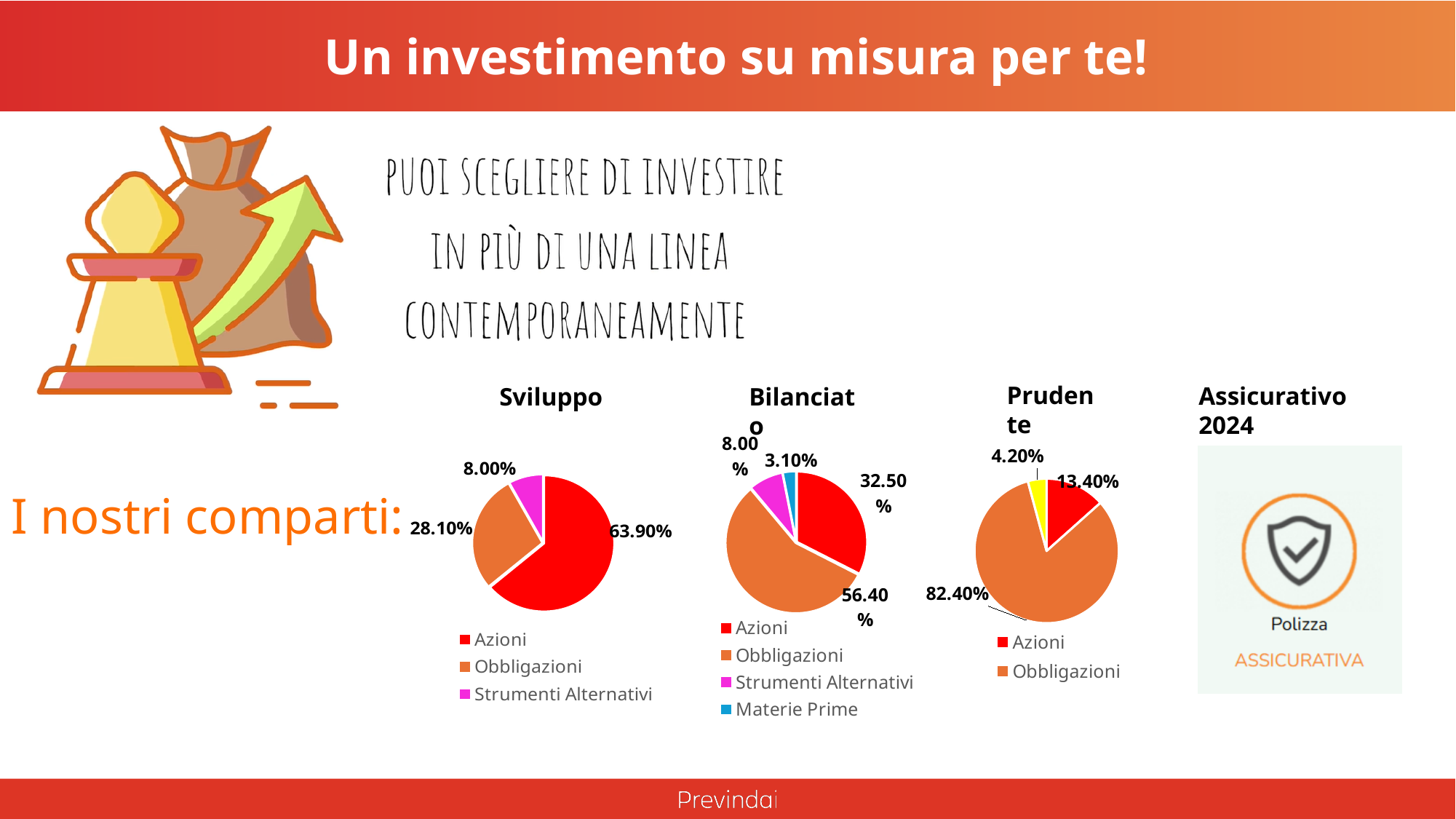
What kind of chart is the Sviluppo chart? pie chart In the Sviluppo chart, which category has the largest slice? Azioni In the Bilanciato chart, what is the difference between the Obbligazioni and Azioni shares? 23.90% How many categories does the legend of the Bilanciato chart list? 4 In the Sviluppo chart, what share is Azioni? 63.90% In the Sviluppo chart, what share is Obbligazioni? 28.10% In the Bilanciato chart, what share is Materie Prime? 3.10% In the Sviluppo chart, which category has the smallest slice? Strumenti Alternativi In the Prudente chart, which is larger, Azioni or Obbligazioni? Obbligazioni In the Prudente chart, what share is Obbligazioni? 82.40% In the Sviluppo chart, what colour is the Strumenti Alternativi slice? magenta In the Bilanciato chart, what share is Obbligazioni? 56.40%